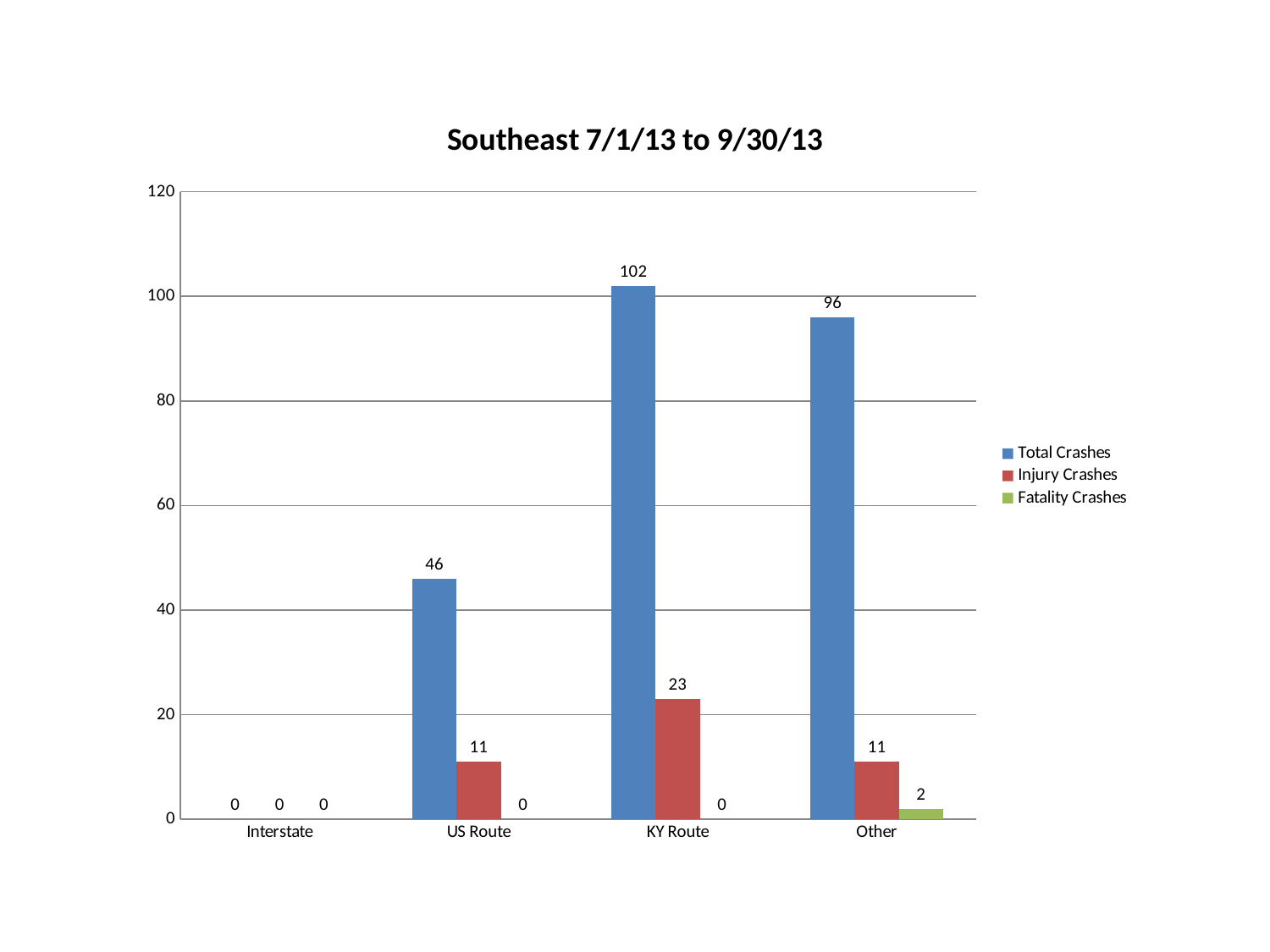
Which category has the lowest Injury Crashes? Interstate How many categories are shown on the x axis? 4 How many series does the legend list? 3 What is the value of Injury Crashes for US Route? 11 What kind of chart is shown on the slide? Bar chart What is the difference between Total Crashes for KY Route and Other? 6 What colour represents Fatality Crashes in the legend? Green What is the title of the chart? Southeast 7/1/13 to 9/30/13 What is the value of Fatality Crashes for Other? 2 What is the value of Total Crashes for KY Route? 102 Which is larger, Injury Crashes for KY Route or Injury Crashes for Other? KY Route Which category has the highest Total Crashes? KY Route